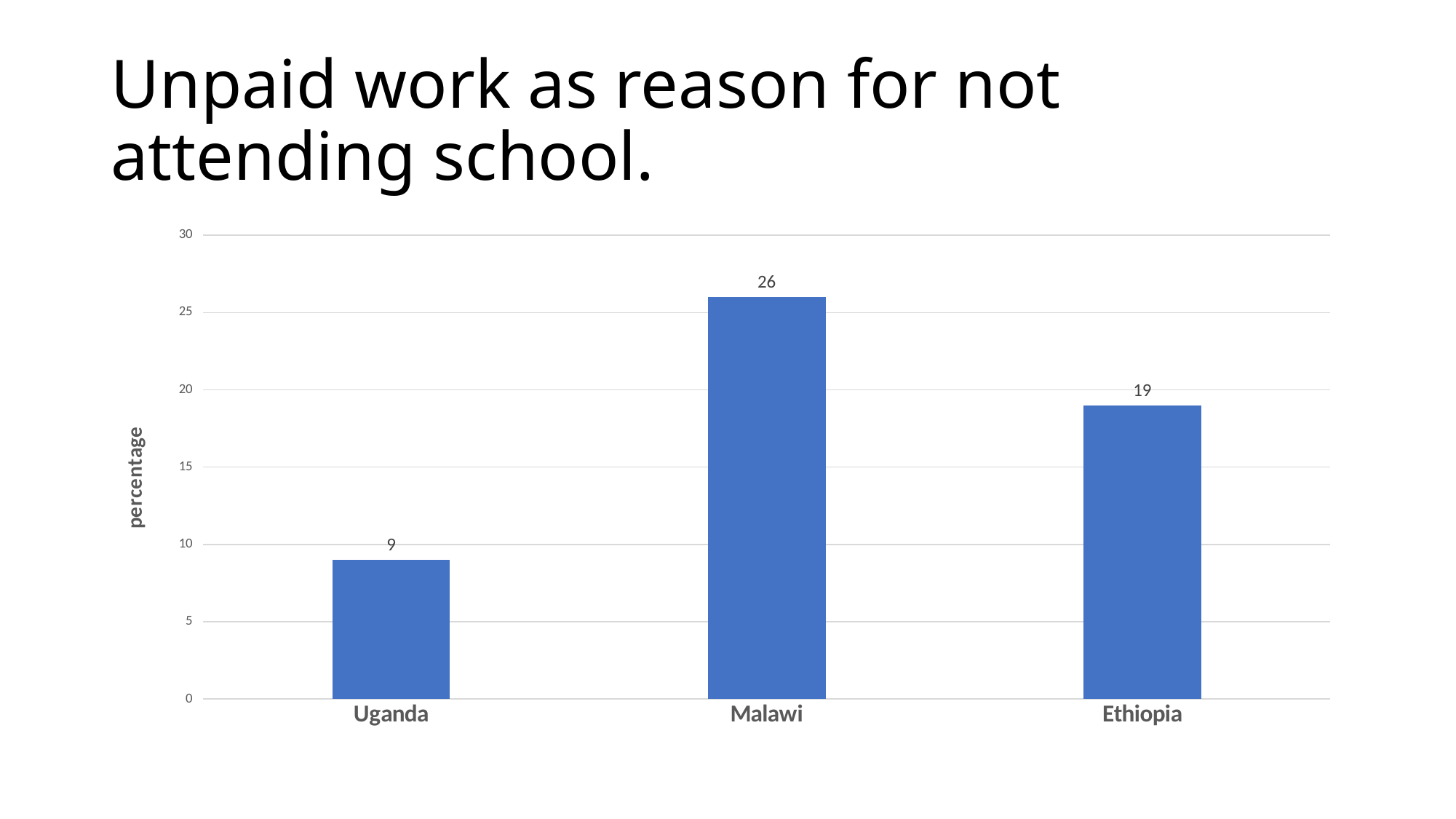
How many countries are shown in the chart? 3 Which country has the lowest value? Uganda What is the value for Malawi? 26 Is the value for Ethiopia greater or less than 20? less Which country has the highest value? Malawi What is the value for Uganda? 9 What is the difference between the values for Malawi and Uganda? 17 Which is larger, the value for Ethiopia or the value for Uganda? Ethiopia What is the difference between the values for Malawi and Ethiopia? 7 What kind of chart is shown on the slide? bar chart What is the label on the vertical axis of the chart? percentage What is the value for Ethiopia? 19